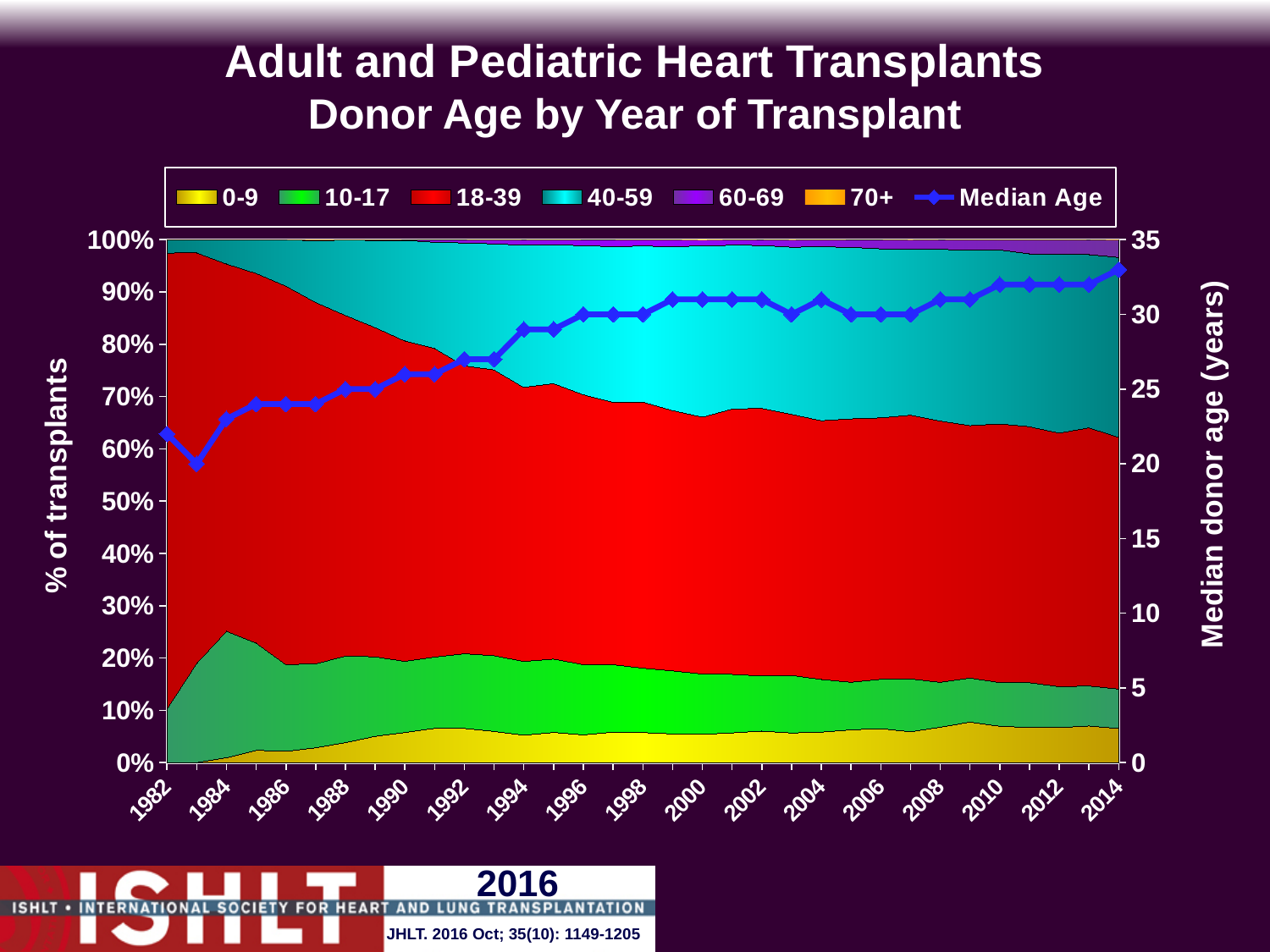
Is the median donor age in 1994 greater or less than 30 years? less Is the median donor age in 2000 greater or less than 30 years? greater Does the median donor age generally rise or fall from 1982 to 2014? rise In which year is the median donor age at its lowest? 1983 What is the title of the right-hand vertical axis? Median donor age (years) Which year has the higher median donor age, 1982 or 2014? 2014 Is the median donor age in 2014 greater or less than 30 years? greater Does the share of transplants from donors aged 18-39 rise or fall from 1984 to 2014? fall In which year is the median donor age at its highest? 2014 How many series does the legend list? 7 What kind of chart is shown on the slide? Stacked area chart with a line for median age